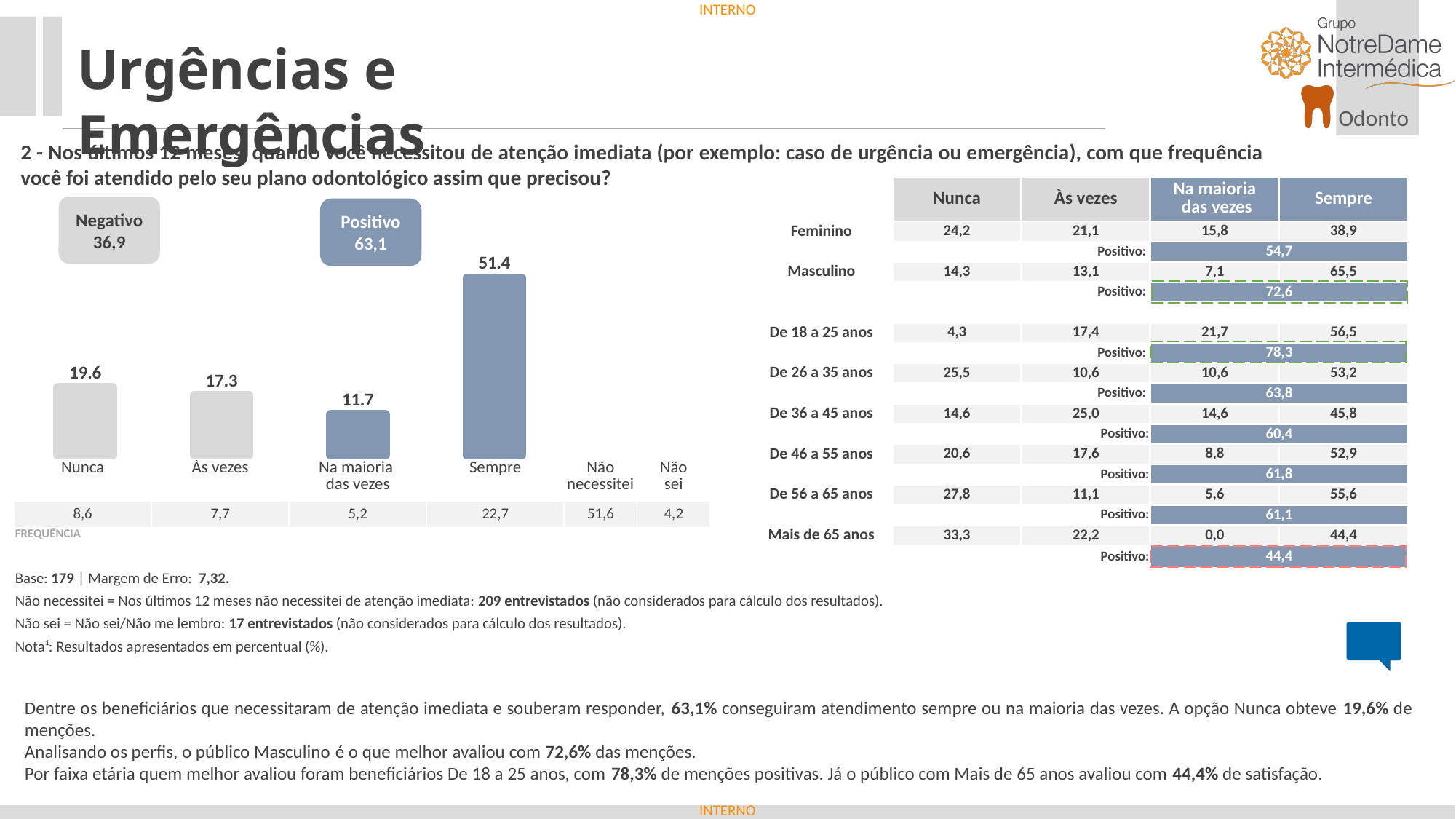
What is the value shown for the Nunca bar in the bar chart? 19.6 Which category has the highest bar in the bar chart? Sempre How many bars with data labels are plotted in the bar chart? 4 What value is shown in the Positivo box above the bar chart? 63,1 Which category has the lowest bar among the plotted bars in the bar chart? Na maioria das vezes What kind of chart is shown on the left of the slide? Bar chart What is the value shown for the Sempre bar in the bar chart? 51.4 What is the value shown for the Na maioria das vezes bar in the bar chart? 11.7 What is the difference between the Sempre bar and the Nunca bar in the bar chart? 31.8 What is the value shown for the Às vezes bar in the bar chart? 17.3 What is the difference between the Às vezes bar and the Na maioria das vezes bar in the bar chart? 5.6 Which is larger in the bar chart, the Nunca bar or the Às vezes bar? Nunca